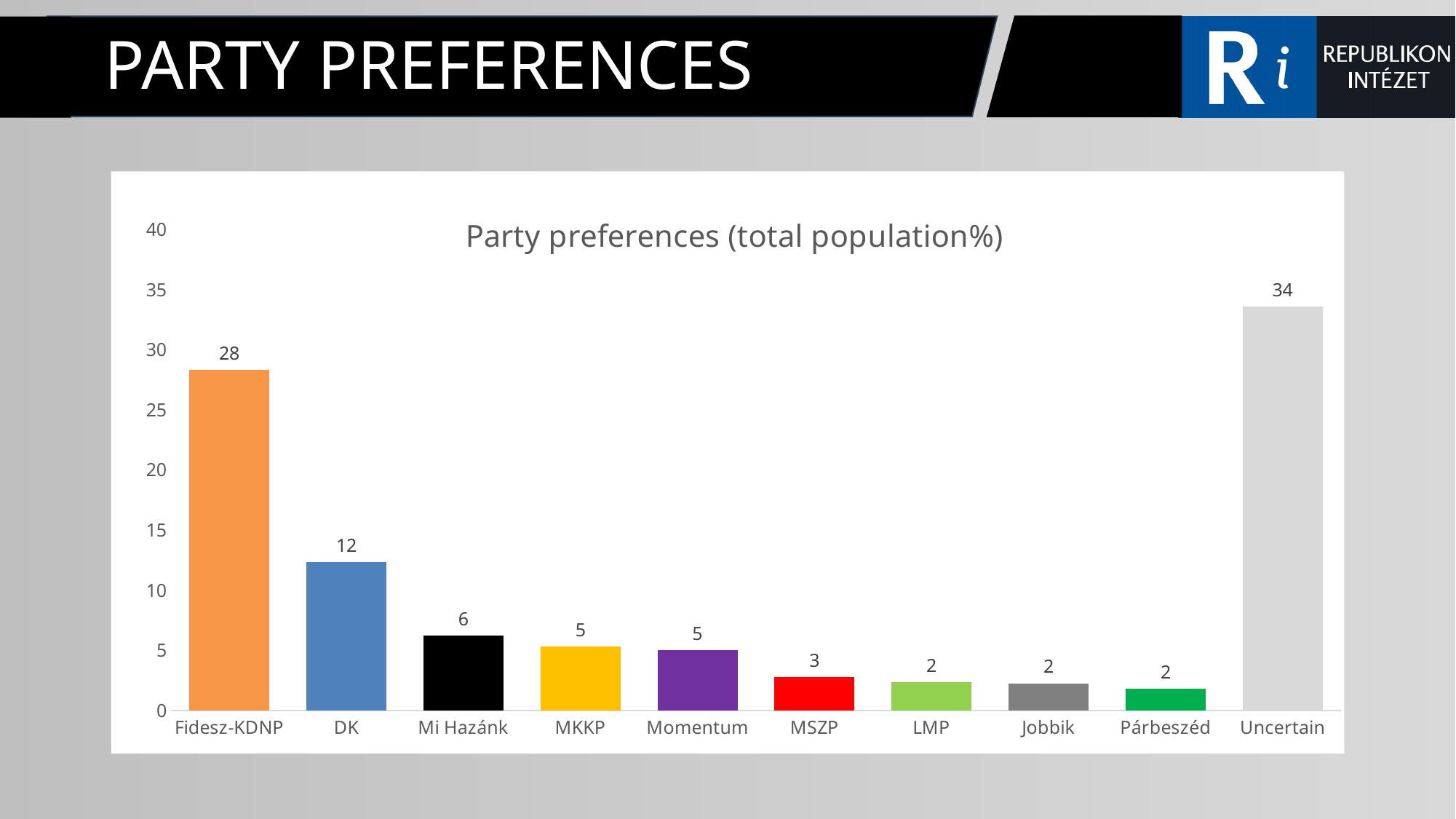
What is the difference between the values for Fidesz-KDNP and DK? 16 What is the value for Fidesz-KDNP? 28 What kind of chart is shown on the slide? Bar chart Which category has the highest value? Uncertain How many categories are shown on the x axis? 10 What is the value for Uncertain? 34 What is the value for MSZP? 3 What is the difference between the values for Uncertain and Fidesz-KDNP? 6 What is the value for DK? 12 What is the title of the chart? Party preferences (total population%) Which party has the highest value among the named parties (excluding Uncertain)? Fidesz-KDNP Which is larger, the value for Mi Hazánk or the value for MSZP? Mi Hazánk